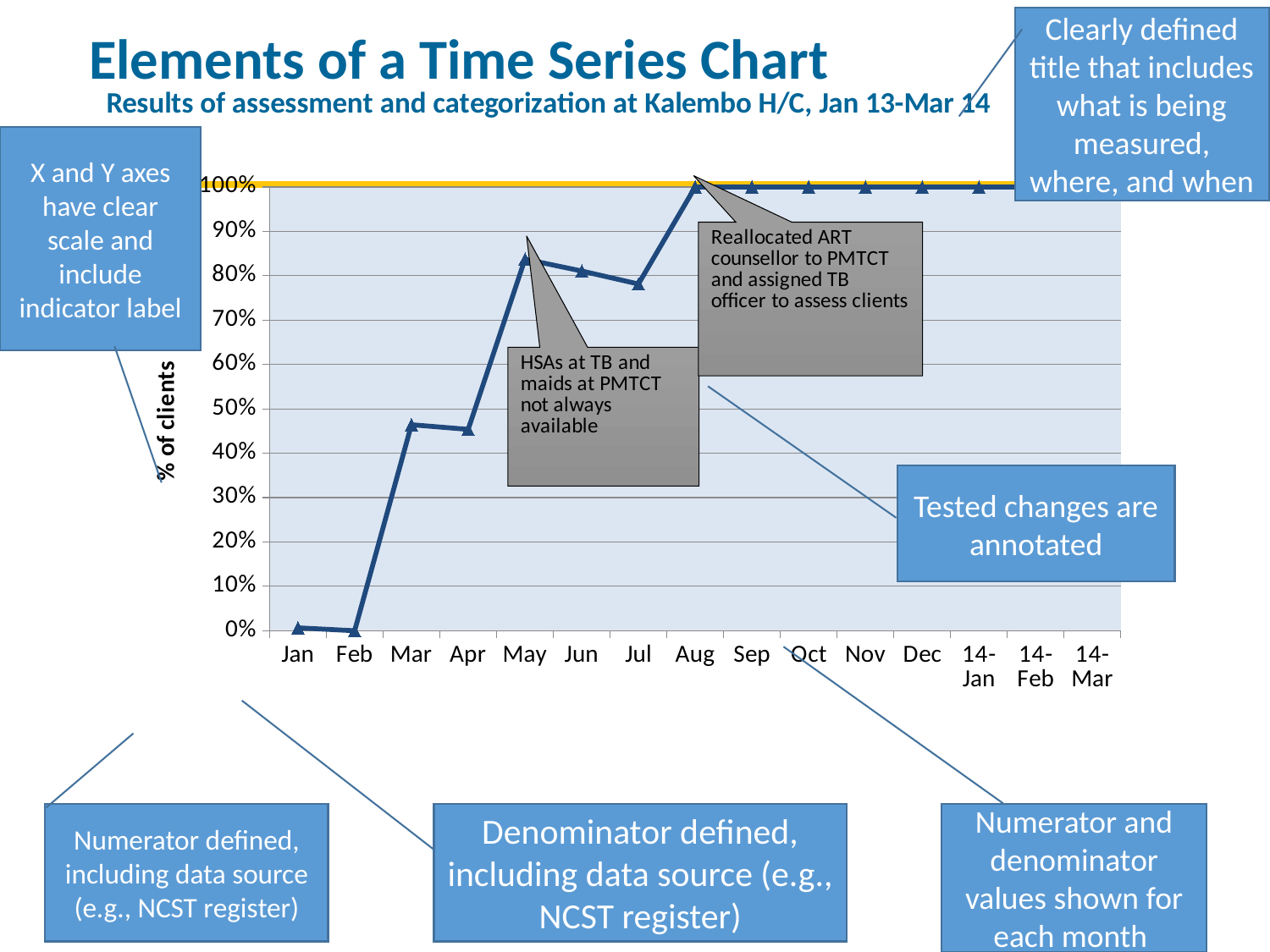
What is the title of the chart? Results of assessment and categorization at Kalembo H/C, Jan 13-Mar 14 Overall, do the values rise or fall from Jan to Aug? rise Is the value for Jul greater or less than 90%? less Which is larger, the value for Mar or the value for May? May How many months are plotted along the x axis of the chart? 15 Is the value for Mar greater or less than 40%? greater What kind of chart is shown on the slide? line chart Is the value for Jan greater or less than 10%? less What is the label of the y axis of the chart? % of clients Which is larger, the value for Apr or the value for Jul? Jul